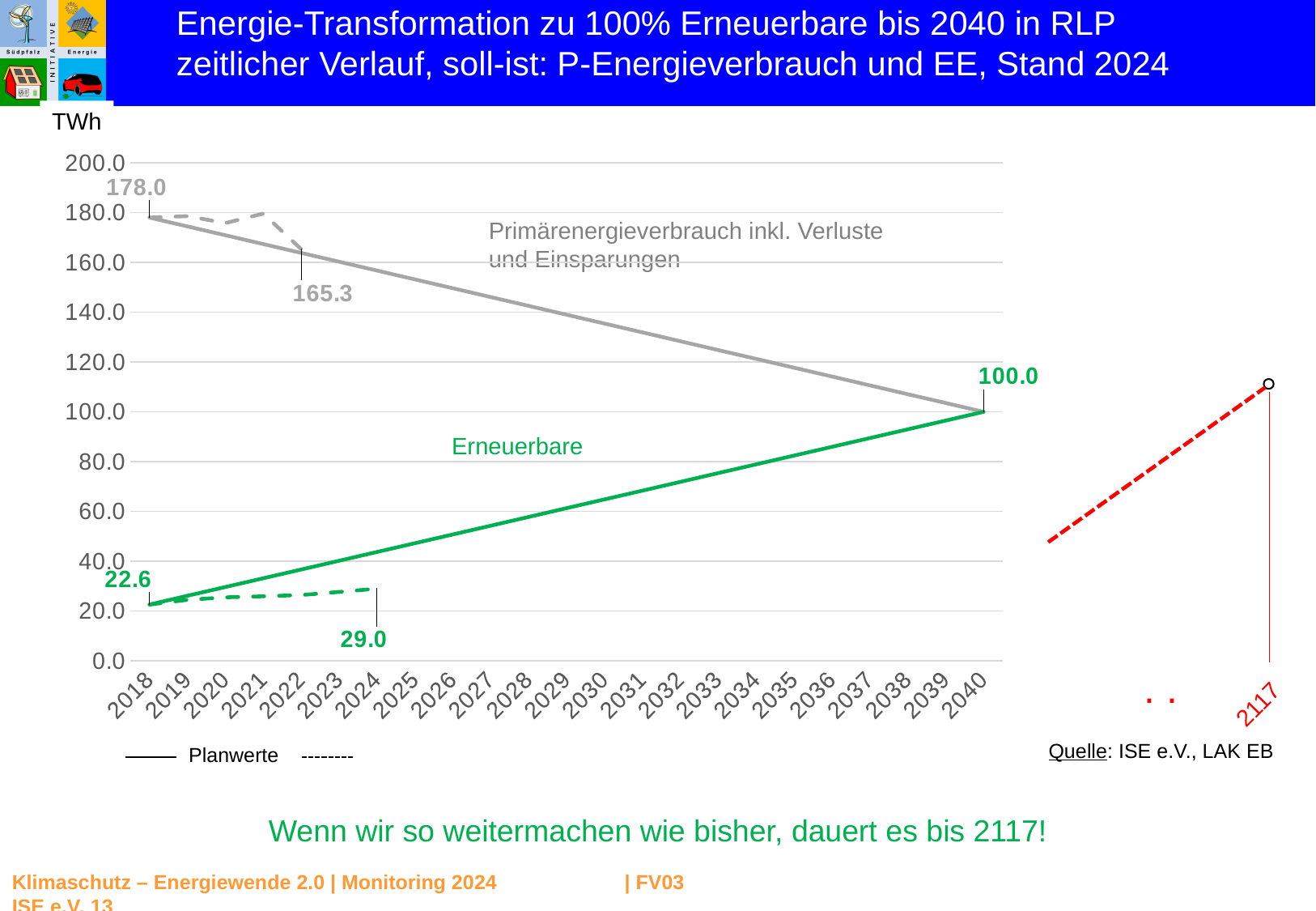
What type of chart is shown on the slide? line chart Which is larger in 2018, the Primärenergieverbrauch value or the Erneuerbare value? Primärenergieverbrauch What is the labelled actual (dashed) value of Erneuerbare in 2024? 29.0 By how much did Erneuerbare increase from 2018 (22.6) to the 2024 actual value (29.0)? 6.4 What unit is shown on the y axis of the chart? TWh Does the Erneuerbare plan line rise or fall from 2018 to 2040? rise What value do the Primärenergieverbrauch and Erneuerbare plan lines reach in 2040? 100.0 What is the value of Primärenergieverbrauch in 2018? 178.0 What is the labelled actual (dashed) value of Primärenergieverbrauch in 2022? 165.3 Is the Erneuerbare plan value in 2030 greater or less than 60.0? greater What is the difference between the Primärenergieverbrauch value in 2018 (178.0) and the 2040 target (100.0)? 78.0 What is the value of Erneuerbare in 2018? 22.6